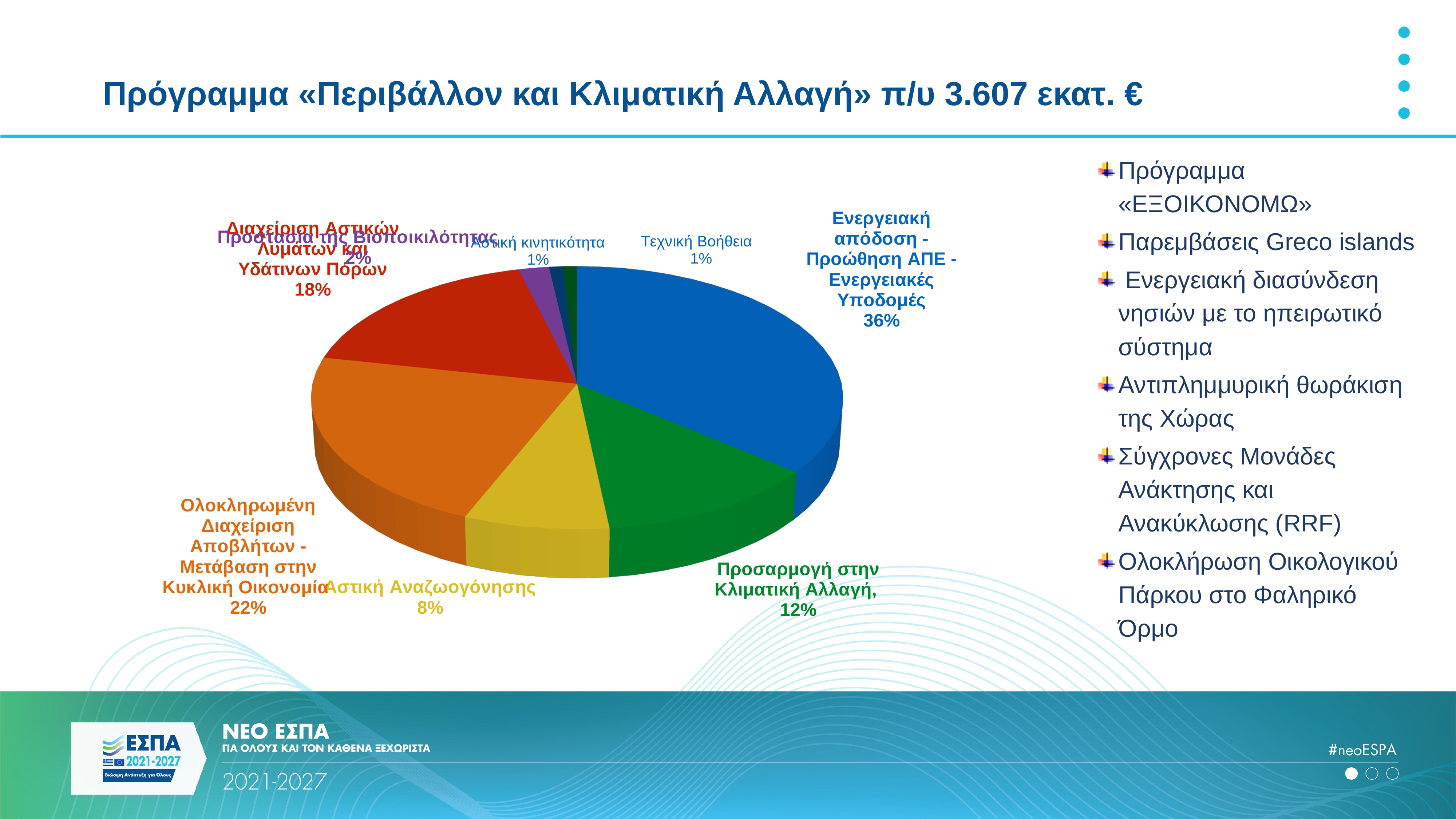
What share of the pie does "Προσαρμογή στην Κλιματική Αλλαγή" have? 12% Which has a larger share: "Προσαρμογή στην Κλιματική Αλλαγή" or "Αστική Αναζωογόνησης"? Προσαρμογή στην Κλιματική Αλλαγή What kind of chart is shown on the slide? pie chart What is the difference in percentage points between "Ενεργειακή απόδοση - Προώθηση ΑΠΕ - Ενεργειακές Υποδομές" and "Ολοκληρωμένη Διαχείριση Αποβλήτων - Μετάβαση στην Κυκλική Οικονομία"? 14 How many slices does the pie chart have? 8 What share of the pie does "Τεχνική Βοήθεια" have? 1% What colour is the slice for "Ενεργειακή απόδοση - Προώθηση ΑΠΕ - Ενεργειακές Υποδομές"? blue Which category has the largest share of the pie? Ενεργειακή απόδοση - Προώθηση ΑΠΕ - Ενεργειακές Υποδομές What is the difference in percentage points between "Ολοκληρωμένη Διαχείριση Αποβλήτων - Μετάβαση στην Κυκλική Οικονομία" and "Προσαρμογή στην Κλιματική Αλλαγή"? 10 What share of the pie does "Αστική Αναζωογόνησης" have? 8% What share of the pie does "Ενεργειακή απόδοση - Προώθηση ΑΠΕ - Ενεργειακές Υποδομές" have? 36% What share of the pie does "Ολοκληρωμένη Διαχείριση Αποβλήτων - Μετάβαση στην Κυκλική Οικονομία" have? 22%